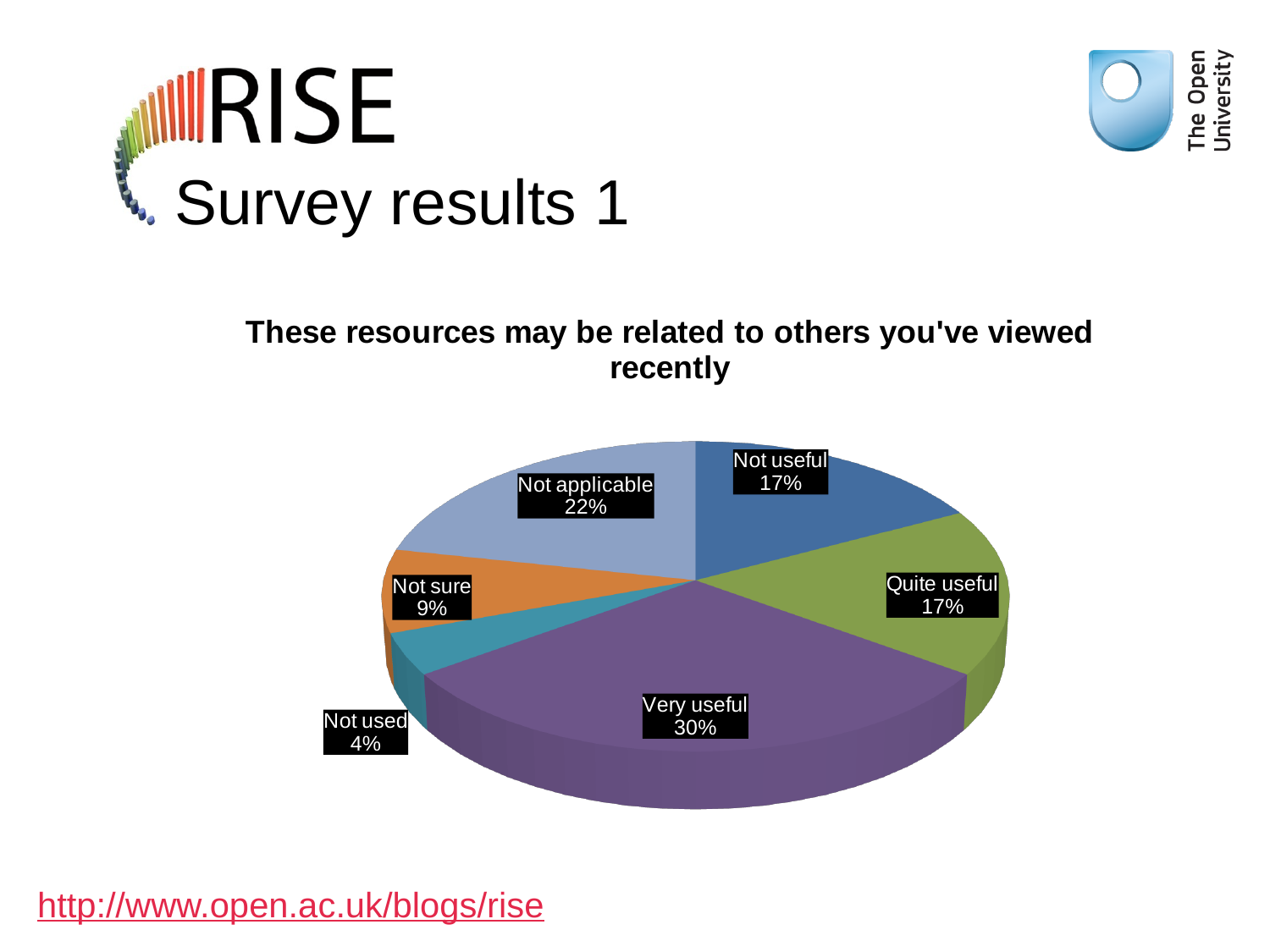
What percentage of respondents answered "Not used"? 4% What is the difference in percentage points between "Very useful" and "Not applicable"? 8 What percentage of respondents answered "Very useful"? 30% What is the title of the chart? These resources may be related to others you've viewed recently What kind of chart is shown on the slide? Pie chart What percentage of respondents answered "Not applicable"? 22% Which response has the smallest share of the pie? Not used Which response has the largest share of the pie? Very useful Which is larger, the share for "Not sure" or the share for "Quite useful"? Quite useful What is the combined share of "Not useful" and "Quite useful"? 34% How many slices does the pie chart have? 6 What percentage of respondents answered "Not sure"? 9%